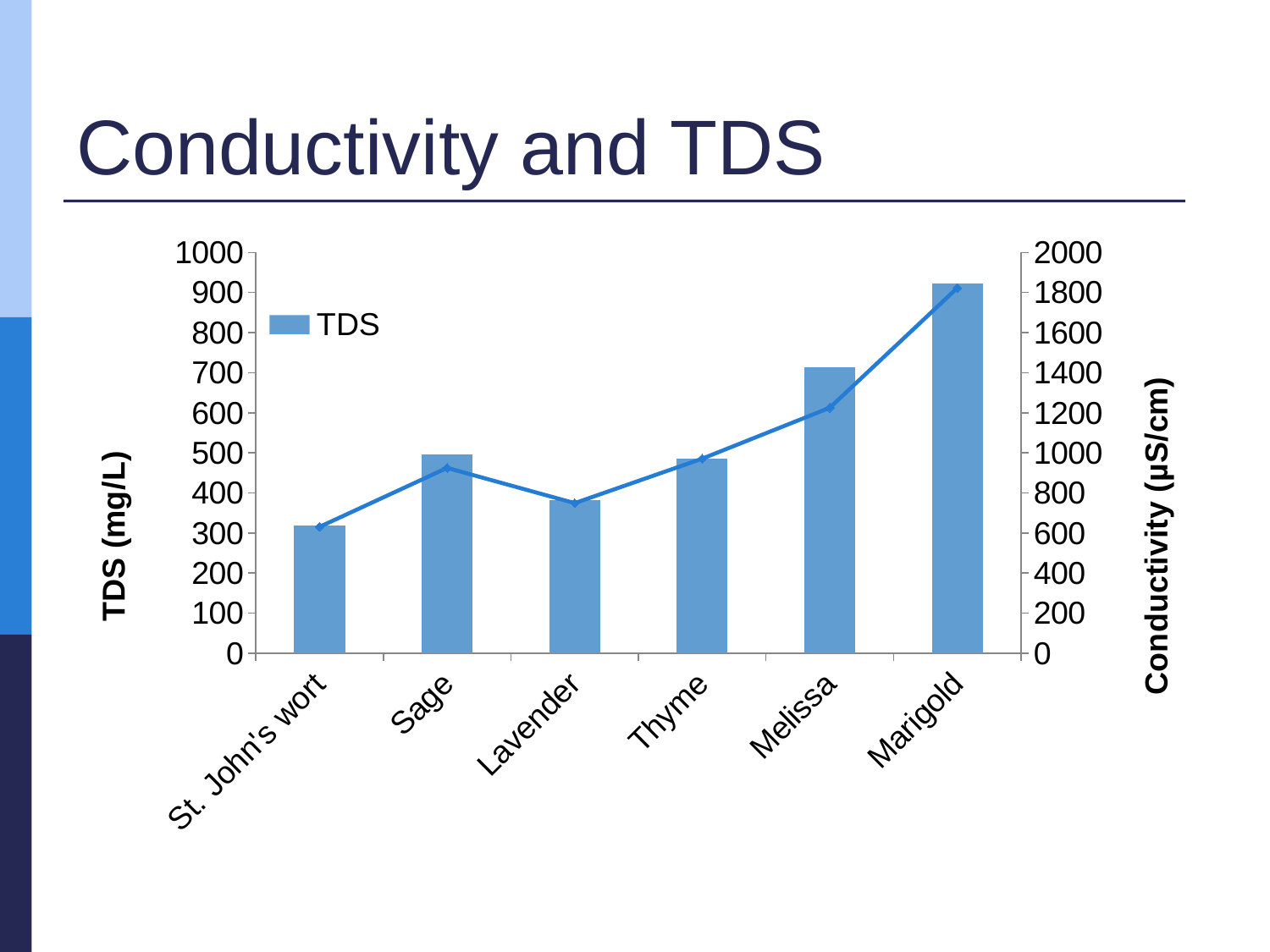
What is the title of the right-hand vertical axis? Conductivity (µS/cm) Is the TDS value for St. John's wort greater or less than 400? less What kind of chart is shown on the slide? bar chart with a line Does the conductivity line rise or fall from Thyme to Marigold? rise Which has a larger TDS value, Melissa or Lavender? Melissa Which plant has the lowest TDS bar? St. John's wort Is the TDS value for Lavender greater or less than 500? less Which plant has the highest TDS bar? Marigold Is the TDS value for Melissa greater or less than 600? greater Which has a larger TDS value, Sage or Marigold? Marigold How many categories (plants) are shown on the x axis of the chart? 6